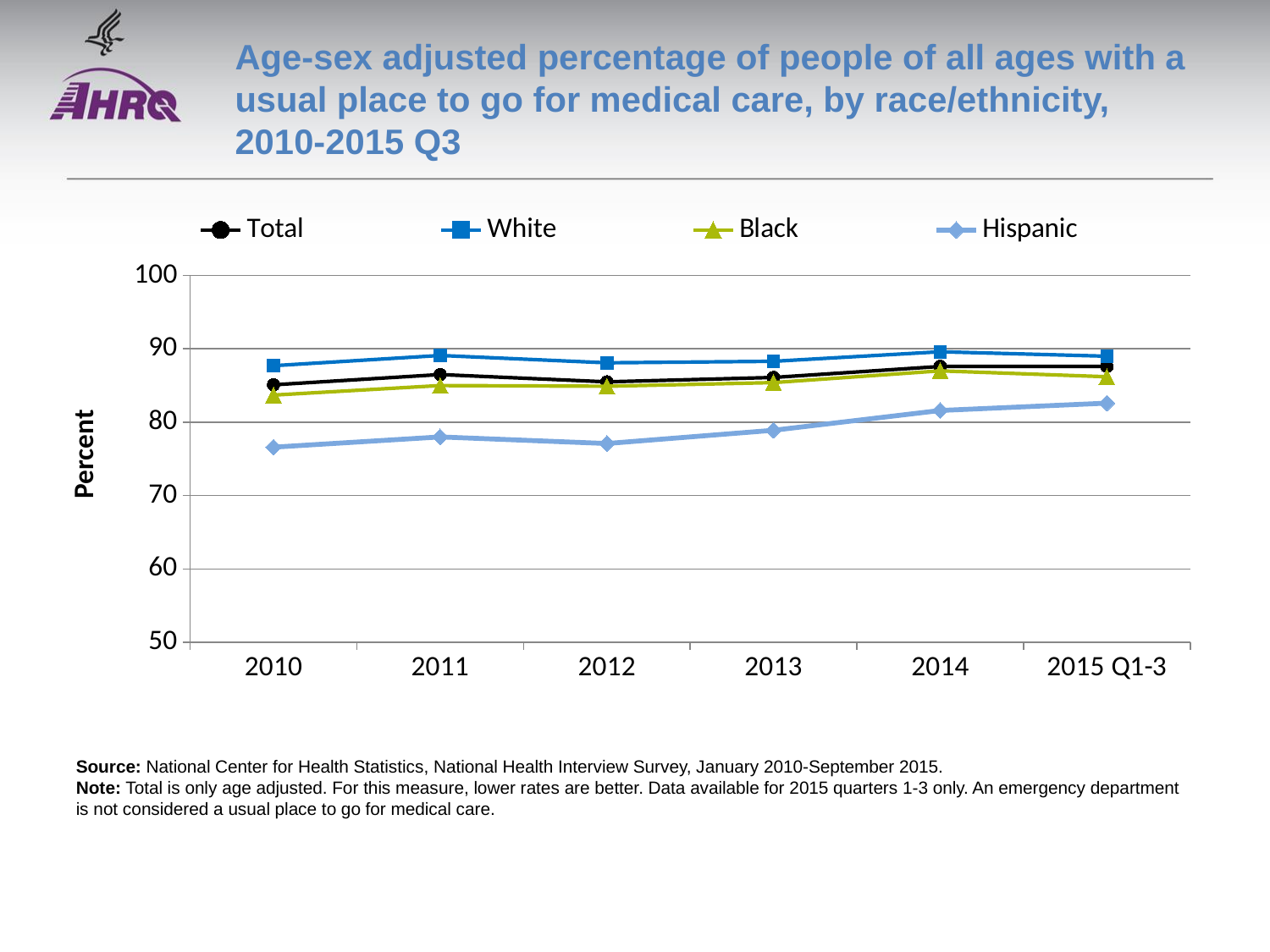
Is the value for Hispanic in 2015 Q1-3 greater or less than 80? greater Is the value for Black in 2010 greater or less than 80? greater Which is larger, the value for White or the value for Hispanic in 2013? White Is the value for Hispanic in 2010 greater or less than 80? less What is the label on the vertical axis? Percent Which race/ethnicity group has the lowest percentage in 2014? Hispanic Which race/ethnicity group has the highest percentage in 2012? White Does the Hispanic line rise or fall overall from 2010 to 2015 Q1-3? Rise What kind of chart is shown on the slide? Line chart How many time points are shown along the x axis? 6 How many series does the legend list? 4